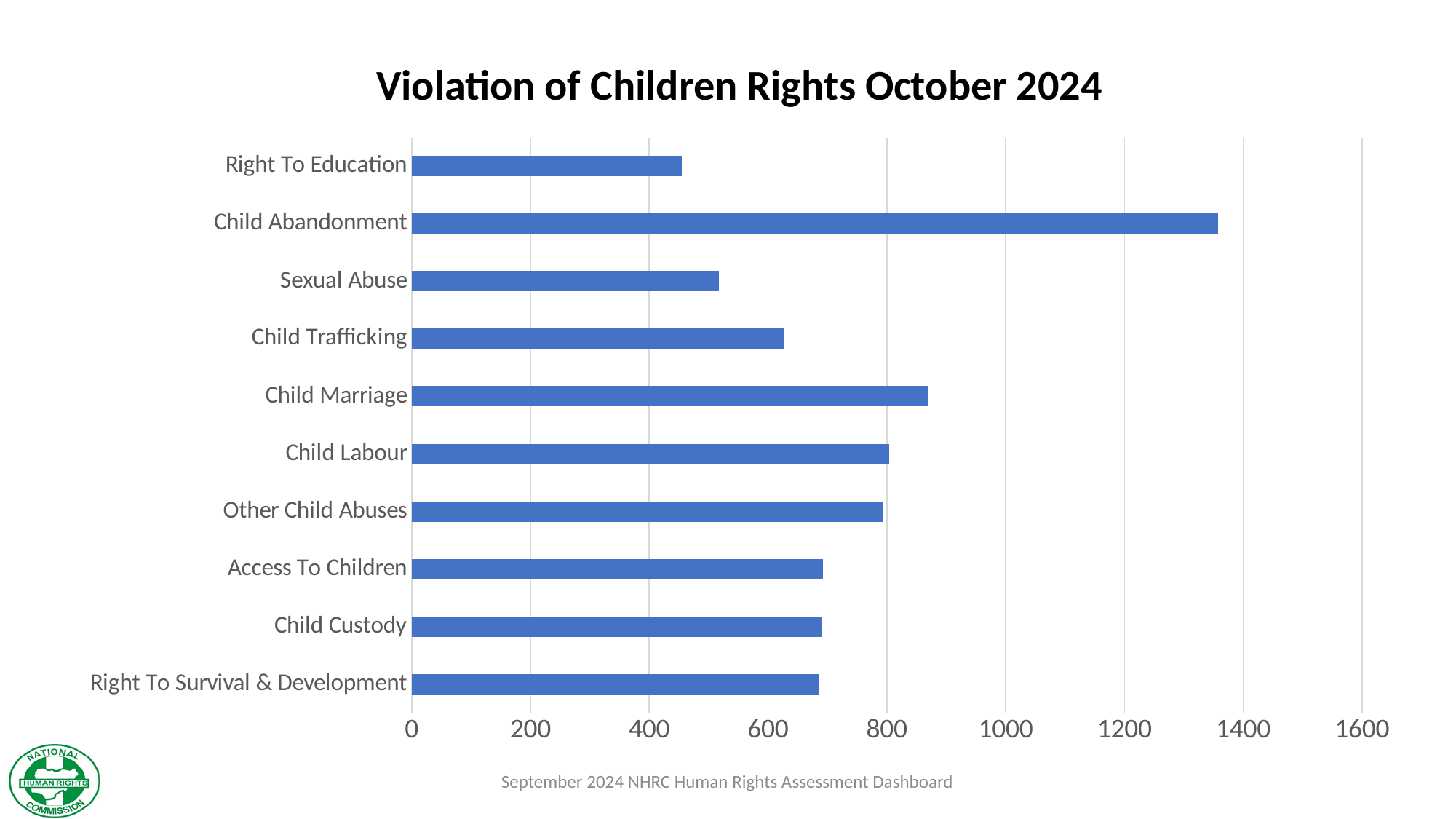
How many categories are plotted in the chart? 10 What is the title of the chart? Violation of Children Rights October 2024 Is the value for Child Marriage greater or less than 800? greater Is the value for Right To Education greater or less than 600? less Which is larger, the value for Child Marriage or the value for Child Labour? Child Marriage Which category has the lowest value? Right To Education Which category has the highest value? Child Abandonment What kind of chart is shown on the slide? bar chart Which is larger, the value for Sexual Abuse or the value for Child Trafficking? Child Trafficking Is the value for Sexual Abuse greater or less than 600? less